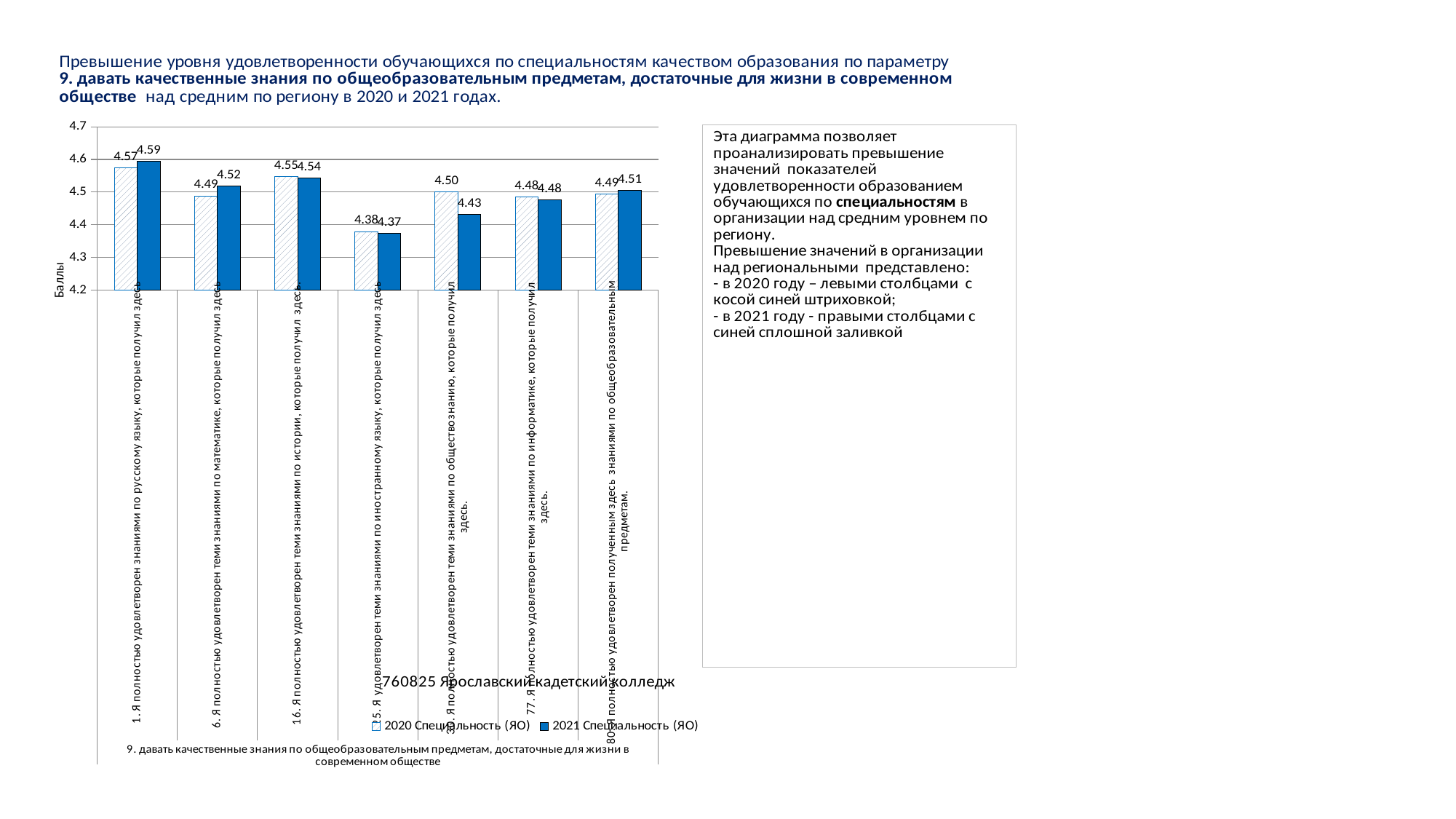
What is the difference between the 2020 and 2021 values for the social studies category (item 30)? 0.07 What is the 2021 value for the category about knowledge of the Russian language (item 1)? 4.59 Which category has the lowest 2020 value? 25. Я удовлетворен теми знаниями по иностранному языку, которые получил здесь How many series does the chart legend list? 2 Which category has the highest 2021 value? 1. Я полностью удовлетворен знаниями по русскому языку, которые получил здесь What is the 2021 value for the category about knowledge of mathematics (item 6)? 4.52 How many categories are shown on the x axis of the chart? 7 For the history category (item 16), which year has the larger value, 2020 or 2021? 2020 What type of chart is shown on the slide? bar chart What is the 2020 value for the category about knowledge of social studies (обществознание, item 30)? 4.50 Is the 2021 value for the foreign language category (item 25) greater or less than 4.4? less What is the label on the vertical axis of the chart? Баллы